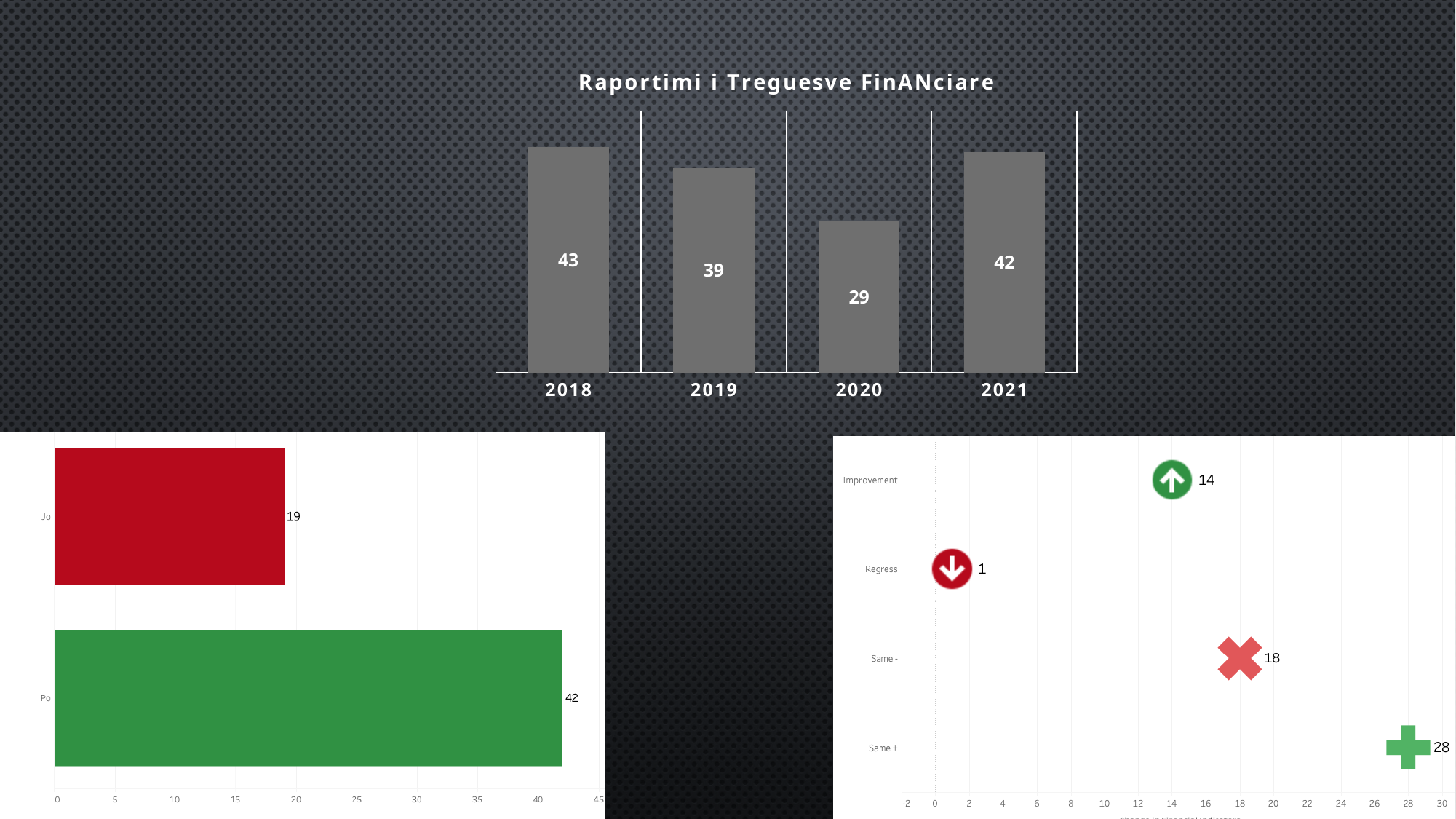
In the bottom-right chart, which category has the lowest value? Regress In the bottom-right chart, what is the value for Same +? 28 In the chart titled 'Raportimi i Treguesve FinANciare', which year has the highest value? 2018 In the chart titled 'Raportimi i Treguesve FinANciare', how many years are shown? 4 What kind of chart is the chart titled 'Raportimi i Treguesve FinANciare'? Bar chart In the chart titled 'Raportimi i Treguesve FinANciare', what is the difference between the values for 2018 and 2019? 4 In the chart titled 'Raportimi i Treguesve FinANciare', which year has the lowest value? 2020 In the bottom-left chart, what is the value for Po? 42 In the bottom-left chart, what colour is the bar for Po? Green In the bottom-left chart, what is the value for Jo? 19 In the bottom-left chart, what is the difference between the values for Po and Jo? 23 In the chart titled 'Raportimi i Treguesve FinANciare', what is the value for 2020? 29